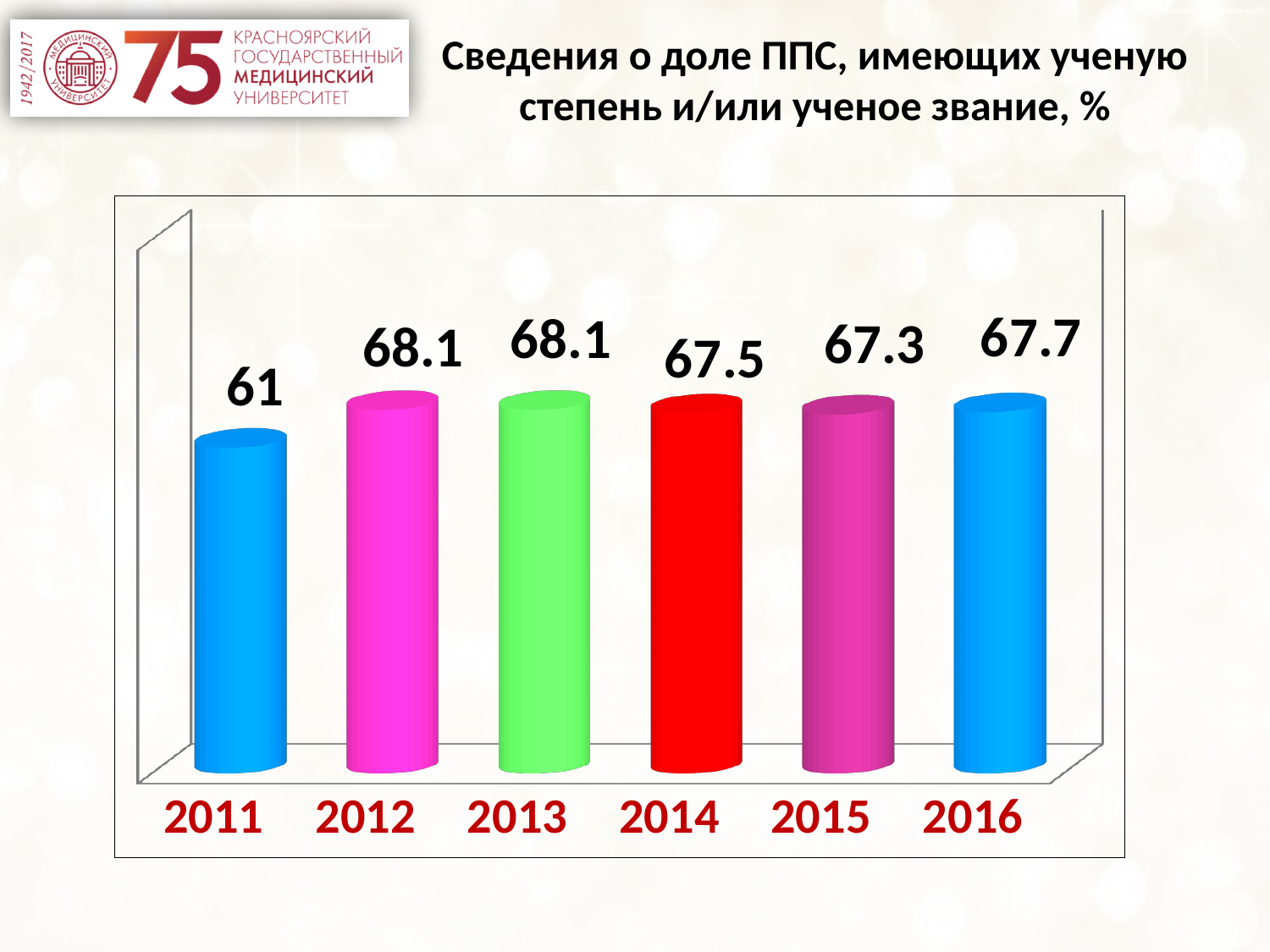
What is the difference between the values for 2012 and 2011? 7.1 What is the value for 2014? 67.5 What colour is the bar for 2013? green What is the value for 2016? 67.7 How many years are shown on the x axis? 6 What is the value for 2015? 67.3 What is the difference between the values for 2016 and 2015? 0.4 What is the value for 2011? 61 Does the value rise or fall from 2011 to 2012? rise Which is larger, the value for 2014 or the value for 2011? 2014 What kind of chart is shown on the slide? bar chart Which year has the lowest value? 2011